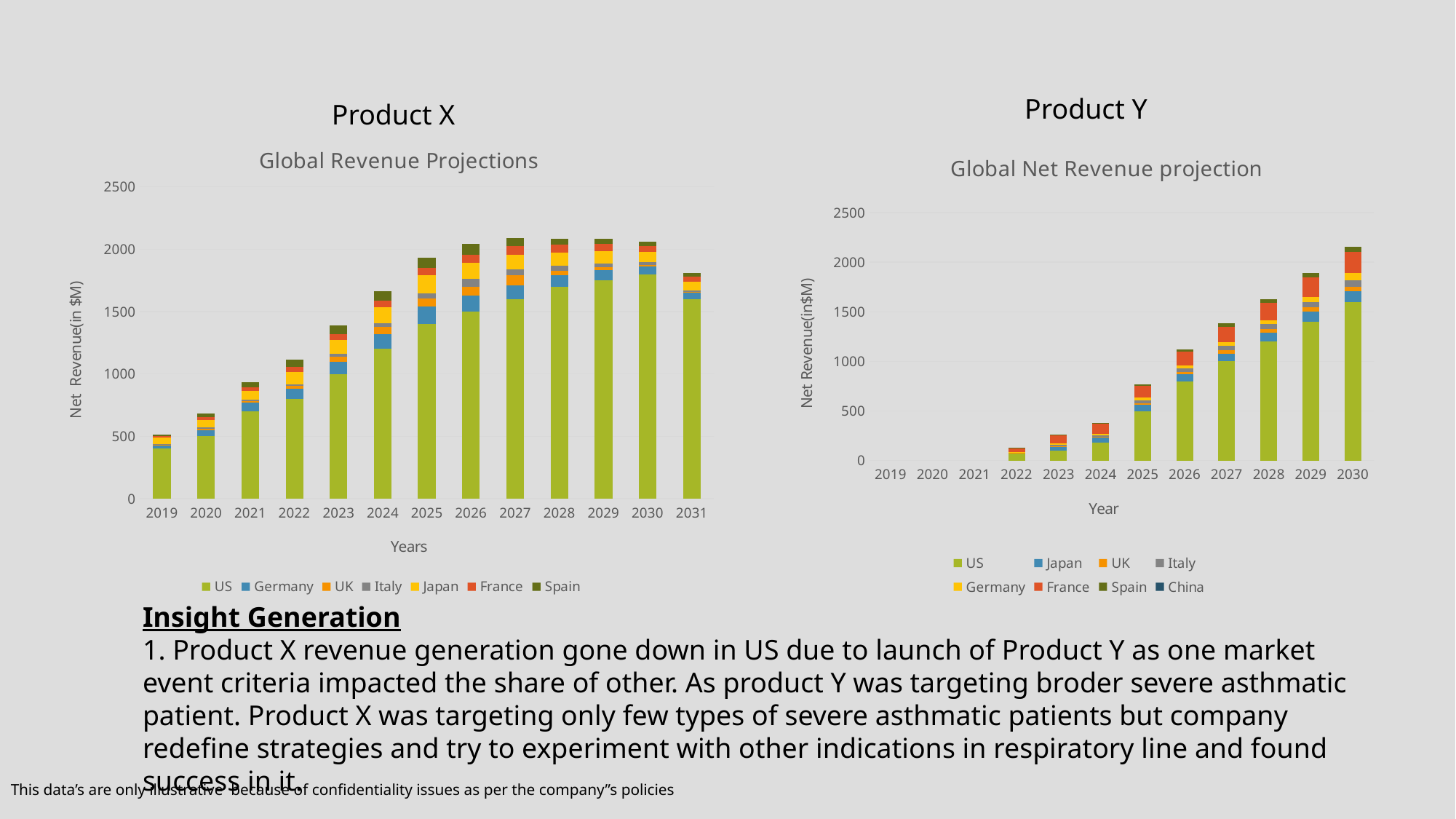
What kind of chart is the Product X 'Global Revenue Projections' chart? Stacked bar chart In the Product Y 'Global Net Revenue projection' chart, which year has the highest total net revenue? 2030 How many years are shown on the x axis of the Product X 'Global Revenue Projections' chart? 13 How many series does the legend of the Product X 'Global Revenue Projections' chart list? 7 In the Product Y 'Global Net Revenue projection' chart, do the totals rise or fall from 2022 to 2030? rise In the Product Y 'Global Net Revenue projection' chart, is the total for 2024 greater or less than 500? less In the Product X 'Global Revenue Projections' chart, which year has the lowest total net revenue? 2019 In the Product X 'Global Revenue Projections' chart, which is larger, the total for 2019 or the total for 2031? 2031 In the Product X 'Global Revenue Projections' chart, is the total for 2023 greater or less than 1500? less How many series does the legend of the Product Y 'Global Net Revenue projection' chart list? 8 How many years are shown on the x axis of the Product Y 'Global Net Revenue projection' chart? 12 In the Product X 'Global Revenue Projections' chart, is the total for 2031 greater or less than 2000? less